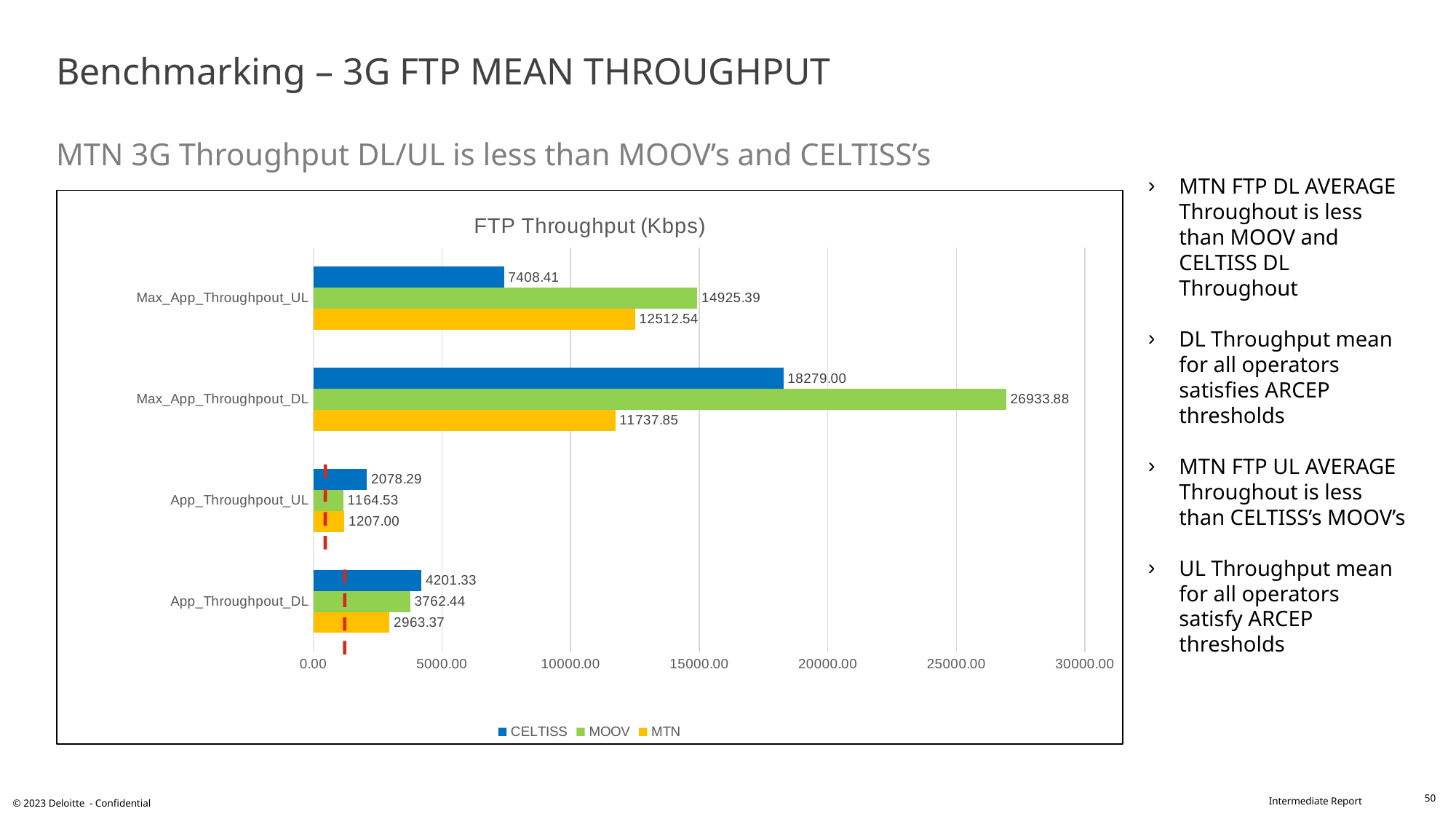
What is the MOOV value for Max_App_Throughpout_DL? 26933.88 What is the MOOV value for App_Throughpout_UL? 1164.53 Which is larger for App_Throughpout_DL: the CELTISS value or the MOOV value? CELTISS What is the difference between the MOOV and MTN values for Max_App_Throughpout_UL? 2412.85 Which operator has the highest Max_App_Throughpout_DL value? MOOV Is the CELTISS value for Max_App_Throughpout_DL greater or less than 15000.00? greater Which operator has the lowest App_Throughpout_DL value? MTN How many categories are shown on the chart? 4 What type of chart is shown on the slide? Bar chart What is the CELTISS value for Max_App_Throughpout_UL? 7408.41 How many series does the legend list? 3 What is the MTN value for App_Throughpout_DL? 2963.37